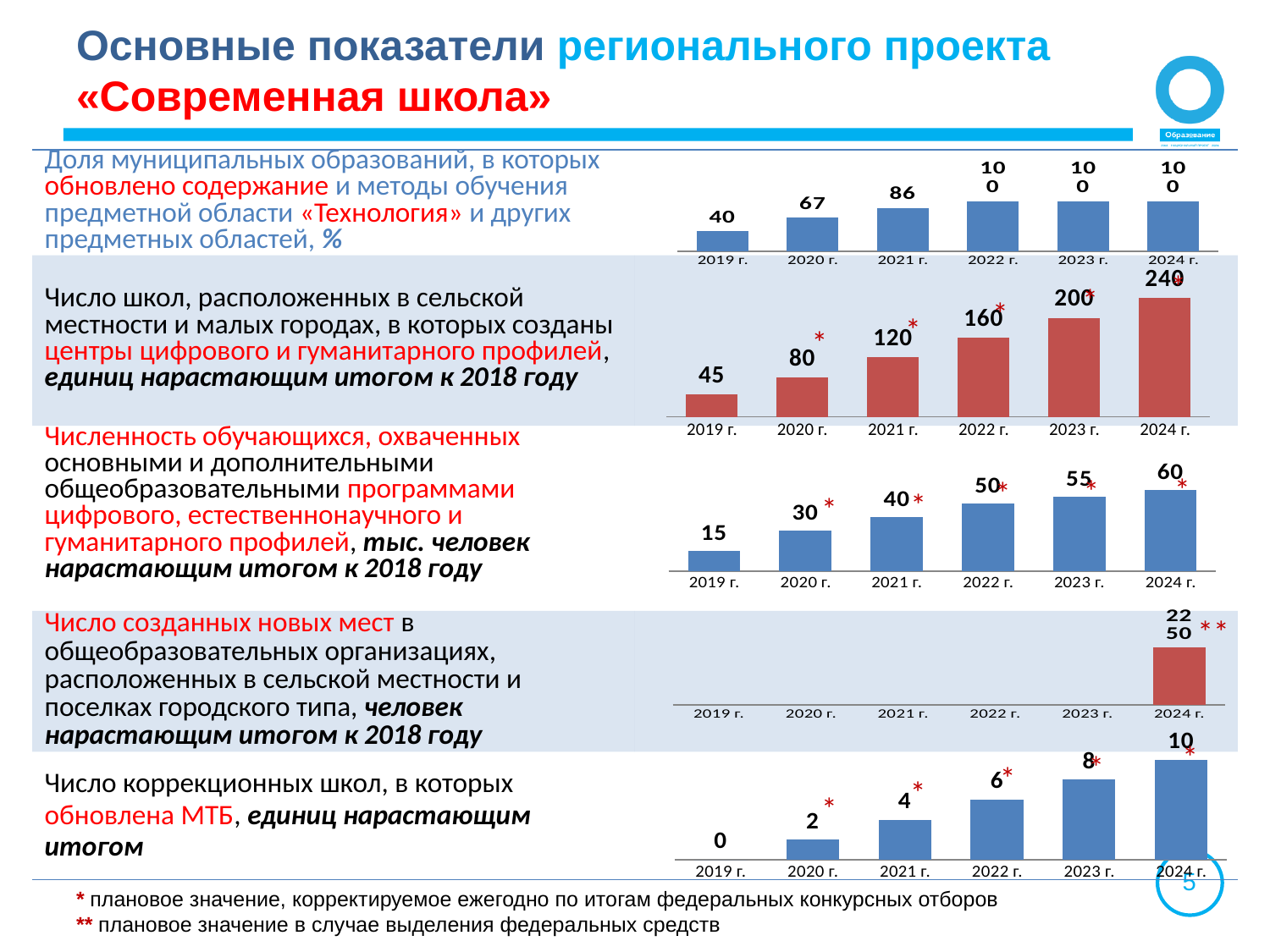
In the third chart (number of students covered, тыс. человек), what is the value for 2023 г.? 55 In the top chart (share of municipalities with updated 'Технология' content, %), what is the value for 2019 г.? 40 In the second chart (number of rural schools with digital and humanities centres), what is the difference between 2024 г. and 2019 г.? 195 In the fourth chart (number of new places created in rural schools), what is the value for 2024 г.? 2250 In the top chart (share of municipalities, %), what is the difference between the 2020 г. and 2019 г. values? 27 In the second chart (number of rural schools with digital and humanities centres), what is the value for 2022 г.? 160 In the bottom chart (number of correctional schools with updated MTB), which year has the lowest value? 2019 г. In the third chart (number of students covered, тыс. человек), do the values rise or fall from 2019 г. to 2024 г.? rise In the bottom chart (number of correctional schools with updated MTB), what is the value for 2021 г.? 4 In the top chart (share of municipalities, %), what is the value for 2021 г.? 86 In the second chart (number of rural schools with digital and humanities centres), which year has the highest value? 2024 г. How many year categories are shown on the x axis of the bottom chart (correctional schools)? 6